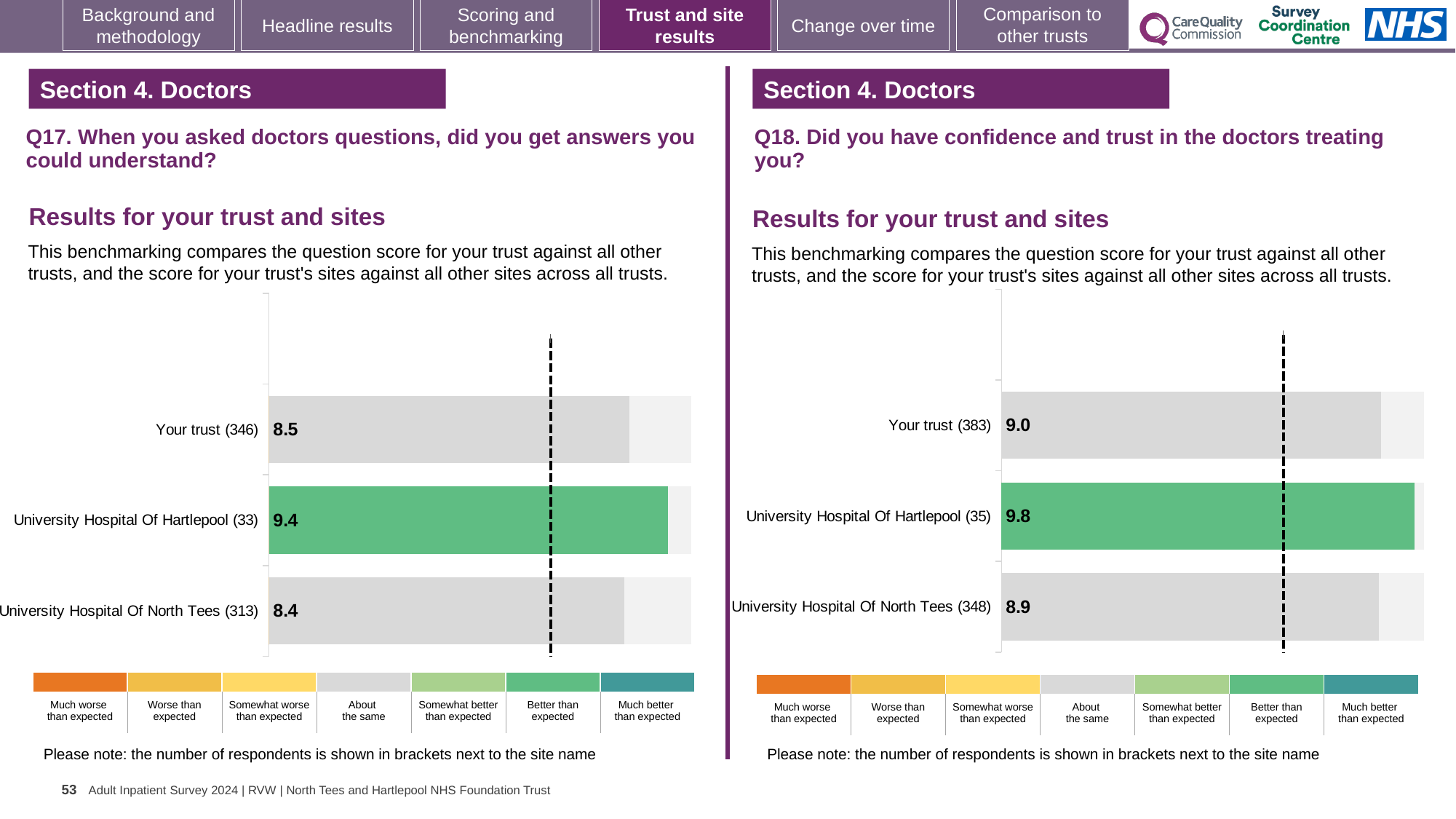
What type of chart is used on the Q17 chart (left)? Bar chart On the Q18 chart (right), what is the score for University Hospital Of Hartlepool? 9.8 How many bars are plotted on the Q18 chart (right)? 3 On the Q18 chart (right), which site or trust has the lowest score? University Hospital Of North Tees On the Q17 chart (left), what is the score for University Hospital Of Hartlepool? 9.4 On the Q18 chart (right), what is the score for Your trust? 9.0 On the Q18 chart (right), which has the larger score, Your trust or University Hospital Of Hartlepool? University Hospital Of Hartlepool On the Q17 chart (left), what is the score for University Hospital Of North Tees? 8.4 On the Q17 chart (left), what is the difference between the scores for University Hospital Of Hartlepool and University Hospital Of North Tees? 1.0 On the Q17 chart (left), which site or trust has the highest score? University Hospital Of Hartlepool On the Q17 chart (left), what is the score for Your trust? 8.5 On the Q18 chart (right), what is the score for University Hospital Of North Tees? 8.9